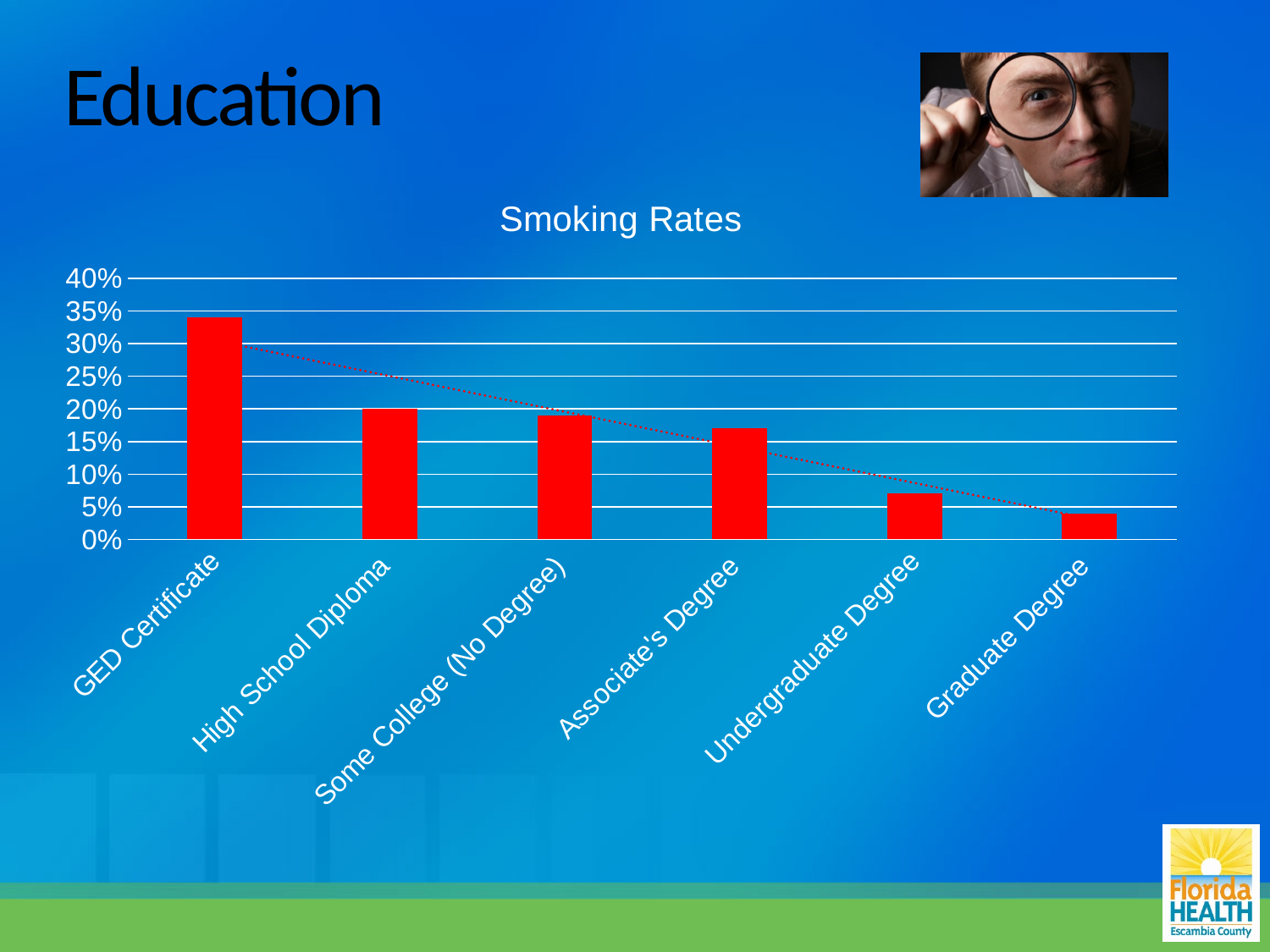
Is the smoking rate for Associate's Degree greater or less than 20%? less What kind of chart is shown on the slide? bar chart How many education categories are plotted in the chart? 6 What colour are the bars in the chart? red What is the title of the chart? Smoking Rates Which has a higher smoking rate, Undergraduate Degree or Graduate Degree? Undergraduate Degree Do the smoking rates generally rise or fall moving from GED Certificate to Graduate Degree along the x axis? fall Is the smoking rate for Undergraduate Degree greater or less than 10%? less Is the smoking rate for GED Certificate greater or less than 30%? greater Which education category has the lowest smoking rate? Graduate Degree Which has a higher smoking rate, GED Certificate or High School Diploma? GED Certificate Which education category has the highest smoking rate? GED Certificate